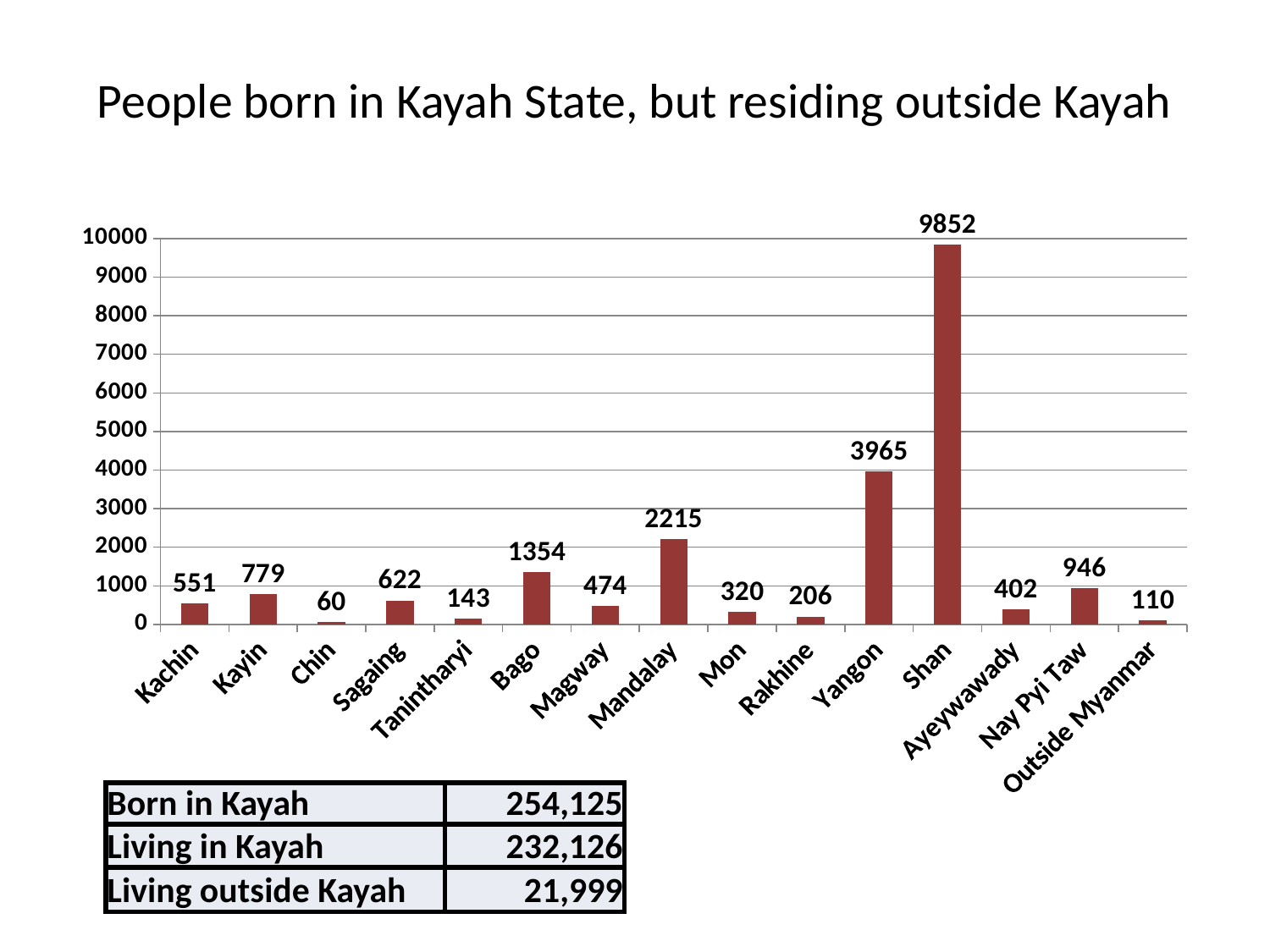
What is the value for Mandalay? 2215 Which category has the highest value? Shan What kind of chart is shown on the slide? bar chart Is the value for Yangon greater or less than 3000? greater How many categories are shown on the x axis? 15 Which is larger, the value for Bago or the value for Nay Pyi Taw? Bago What is the difference between the values for Kayin and Kachin? 228 What is the value for Shan? 9852 What is the difference between the values for Shan and Yangon? 5887 What is the value for Outside Myanmar? 110 What is the title of the chart? People born in Kayah State, but residing outside Kayah Which category has the lowest value? Chin